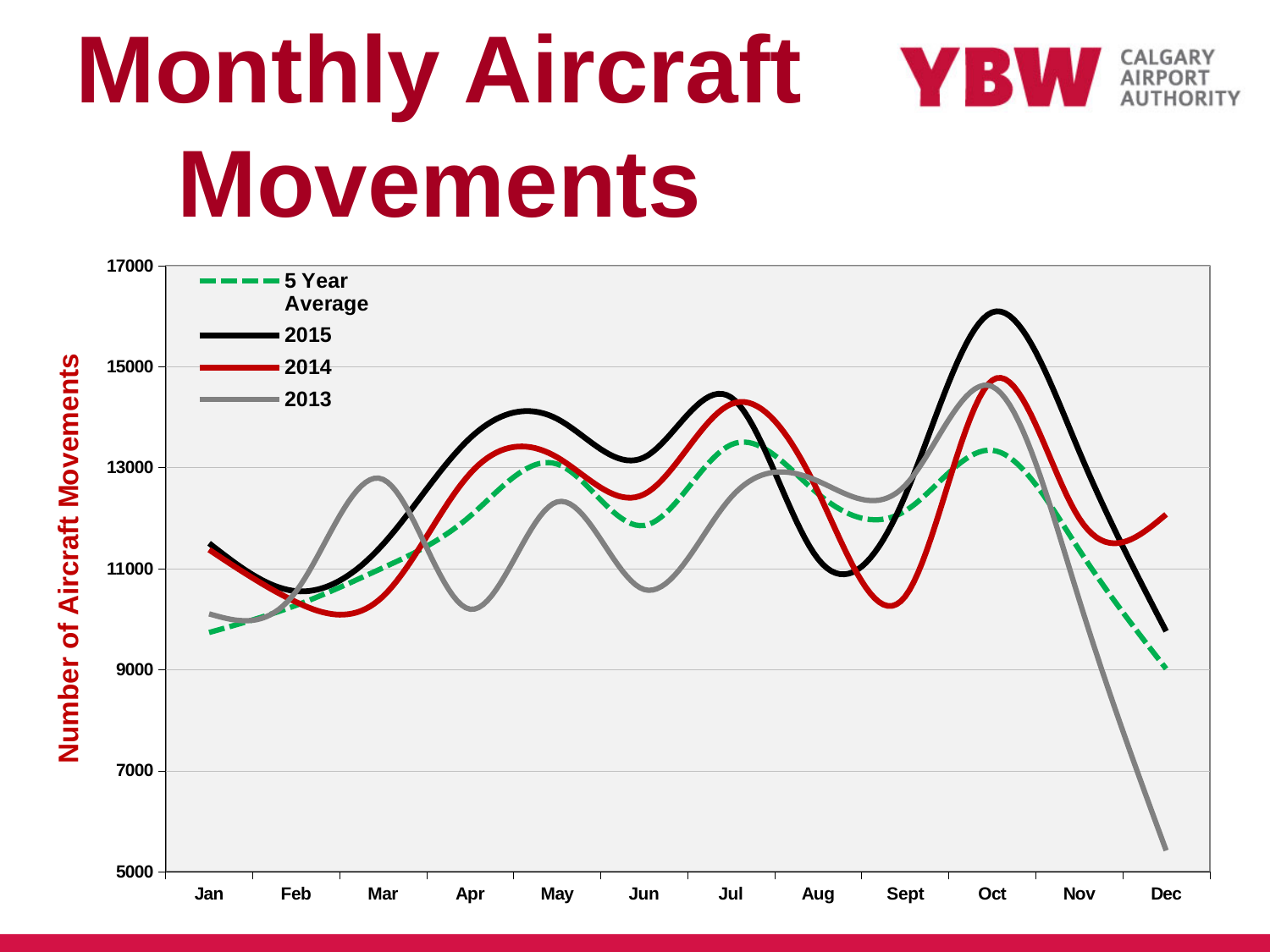
Is the 2013 value for Dec greater or less than 7000? less In which month does the 2013 line reach its lowest value? Dec How many series does the legend list? 4 In which month does the 2015 line reach its highest value? Oct Is the 2014 value for Sept greater or less than 11000? less Which is larger in Oct, the 2015 value or the 2014 value? 2015 Which series is drawn as a dashed green line? 5 Year Average Is the 2015 value for Dec greater or less than 11000? less How many months are shown along the x axis? 12 What kind of chart is shown on the slide? Line chart Do the 2013 values rise or fall from Oct to Dec? Fall